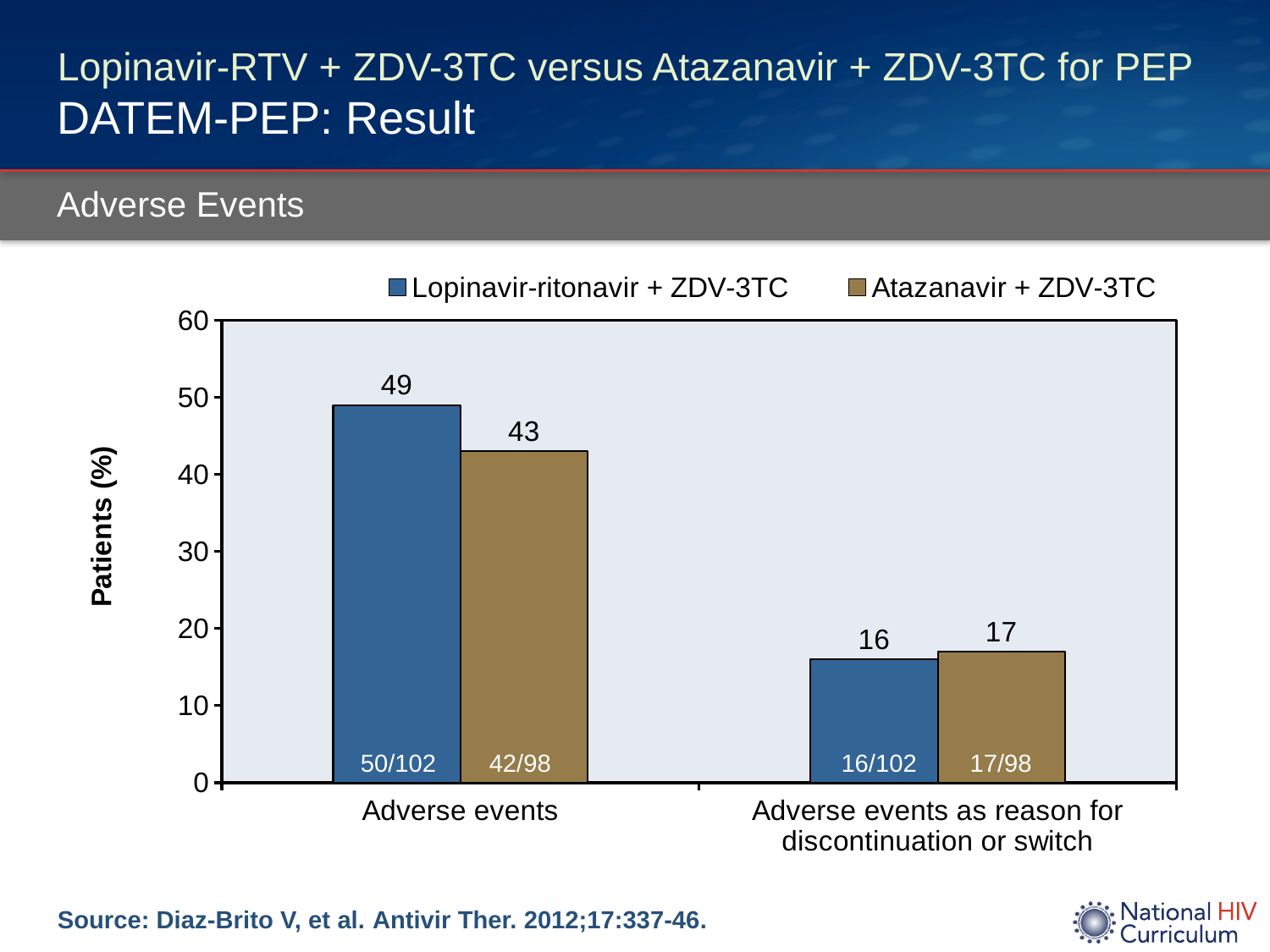
What fraction of patients is printed on the Atazanavir + ZDV-3TC bar for Adverse events as reason for discontinuation or switch? 17/98 Which series has the higher value in the Adverse events category? Lopinavir-ritonavir + ZDV-3TC What is the label of the y axis? Patients (%) What is the value for Atazanavir + ZDV-3TC in the 'Adverse events as reason for discontinuation or switch' category? 17 How many series does the legend list? 2 Which bar has the highest value in the chart? Lopinavir-ritonavir + ZDV-3TC, Adverse events (49) What fraction of patients is printed on the Lopinavir-ritonavir + ZDV-3TC bar for Adverse events? 50/102 What is the difference between the Lopinavir-ritonavir + ZDV-3TC and Atazanavir + ZDV-3TC values in the Adverse events category? 6 What is the value for Atazanavir + ZDV-3TC in the Adverse events category? 43 What kind of chart is shown on the slide? Bar chart What is the value for Lopinavir-ritonavir + ZDV-3TC in the 'Adverse events as reason for discontinuation or switch' category? 16 What is the value for Lopinavir-ritonavir + ZDV-3TC in the Adverse events category? 49